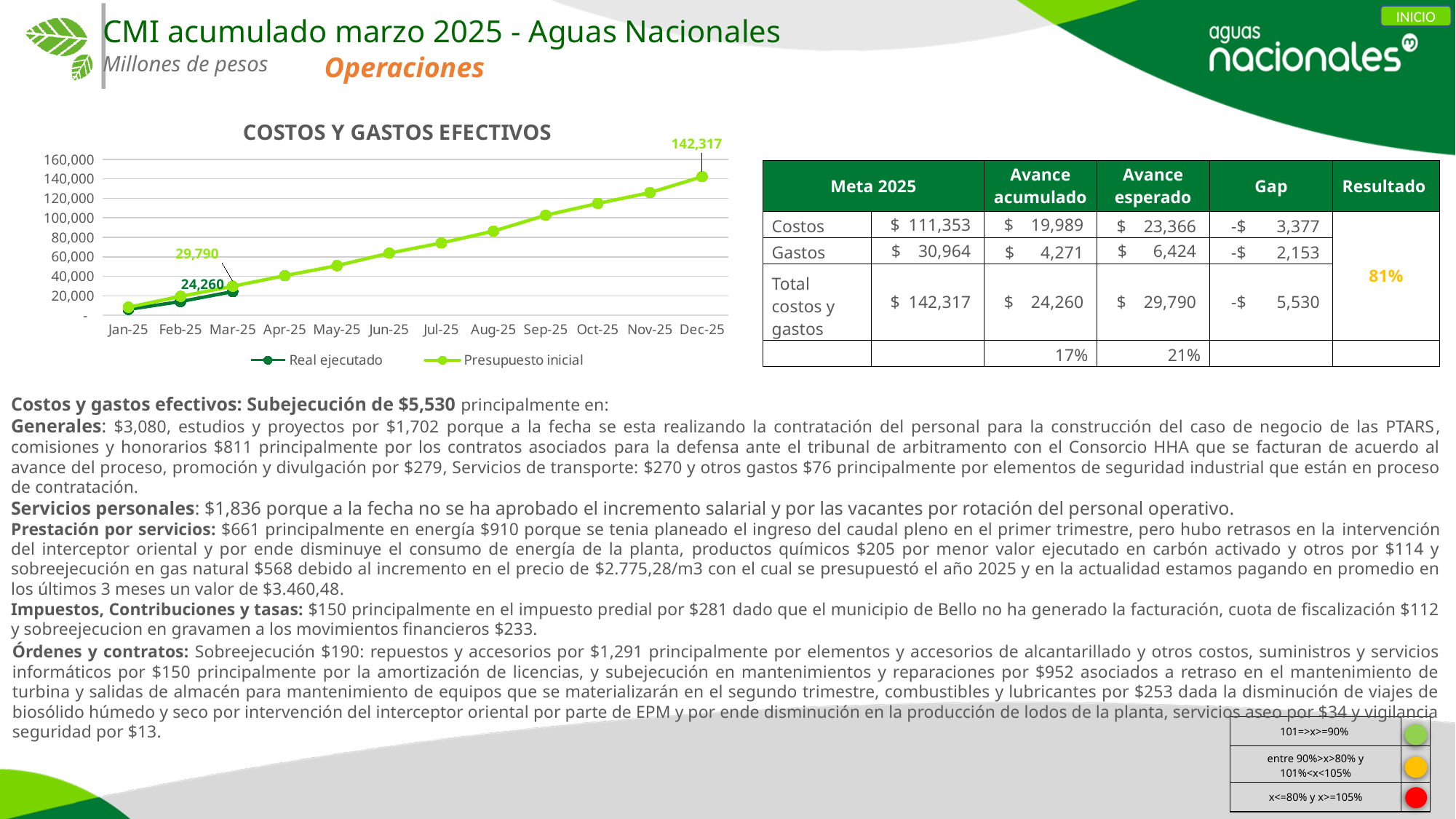
What is the value of Presupuesto inicial at Dec-25? 142,317 What kind of chart is shown on the slide? line chart What is the difference between Presupuesto inicial and Real ejecutado at Mar-25? 5,530 How many series does the legend of the chart list? 2 Does the Presupuesto inicial line rise or fall from Jan-25 to Dec-25? rise Is the value of Presupuesto inicial at Jun-25 greater or less than 80,000? less In which month does Presupuesto inicial reach its highest value? Dec-25 What is the title of the chart? COSTOS Y GASTOS EFECTIVOS How many months are shown on the x axis of the chart? 12 What is the value of Presupuesto inicial at Mar-25? 29,790 At Mar-25, which series has the larger value, Real ejecutado or Presupuesto inicial? Presupuesto inicial What is the value of Real ejecutado at Mar-25? 24,260